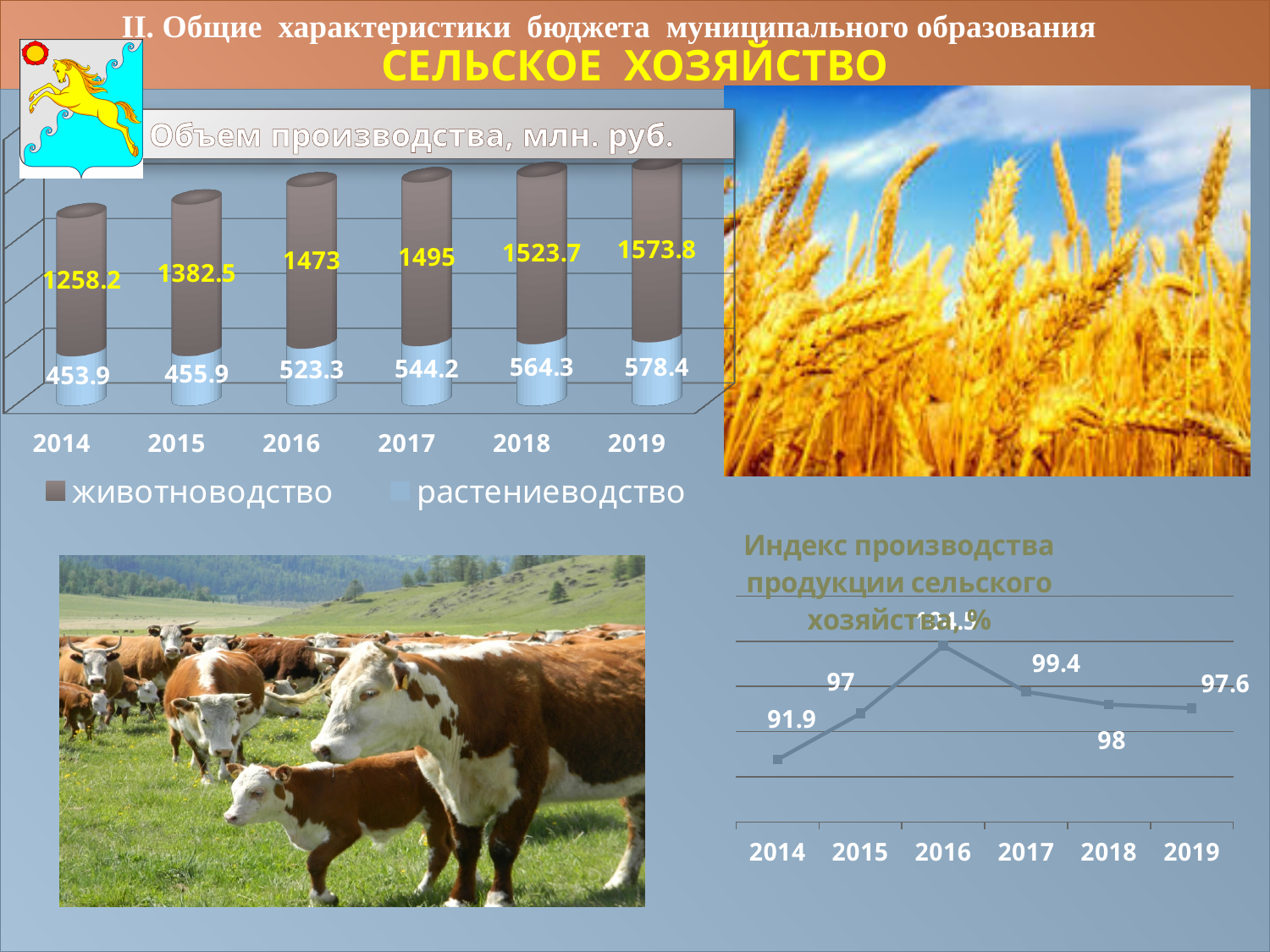
In the chart 'Объем производства, млн. руб.', what is the value for животноводство in 2014? 1258.2 In the chart 'Объем производства, млн. руб.', do the растениеводство values rise or fall from 2014 to 2019? rise In the chart 'Индекс производства продукции сельского хозяйства, %', which is larger, the value for 2017 or the value for 2019? 2017 In the chart 'Индекс производства продукции сельского хозяйства, %', what is the value for 2014? 91.9 In the chart 'Индекс производства продукции сельского хозяйства, %', which year has the highest value? 2016 In the chart 'Объем производства, млн. руб.', which year has the highest value for животноводство? 2019 In the chart 'Объем производства, млн. руб.', how many series does the legend list? 2 In the chart 'Объем производства, млн. руб.', what is the value for растениеводство in 2017? 544.2 In the chart 'Объем производства, млн. руб.', what is the difference between the животноводство values for 2019 and 2014? 315.6 In the chart 'Объем производства, млн. руб.', what is the total of the stacked bar for 2019? 2152.2 In the chart 'Объем производства, млн. руб.', which year has the lowest value for растениеводство? 2014 What kind of chart is 'Объем производства, млн. руб.'? bar chart